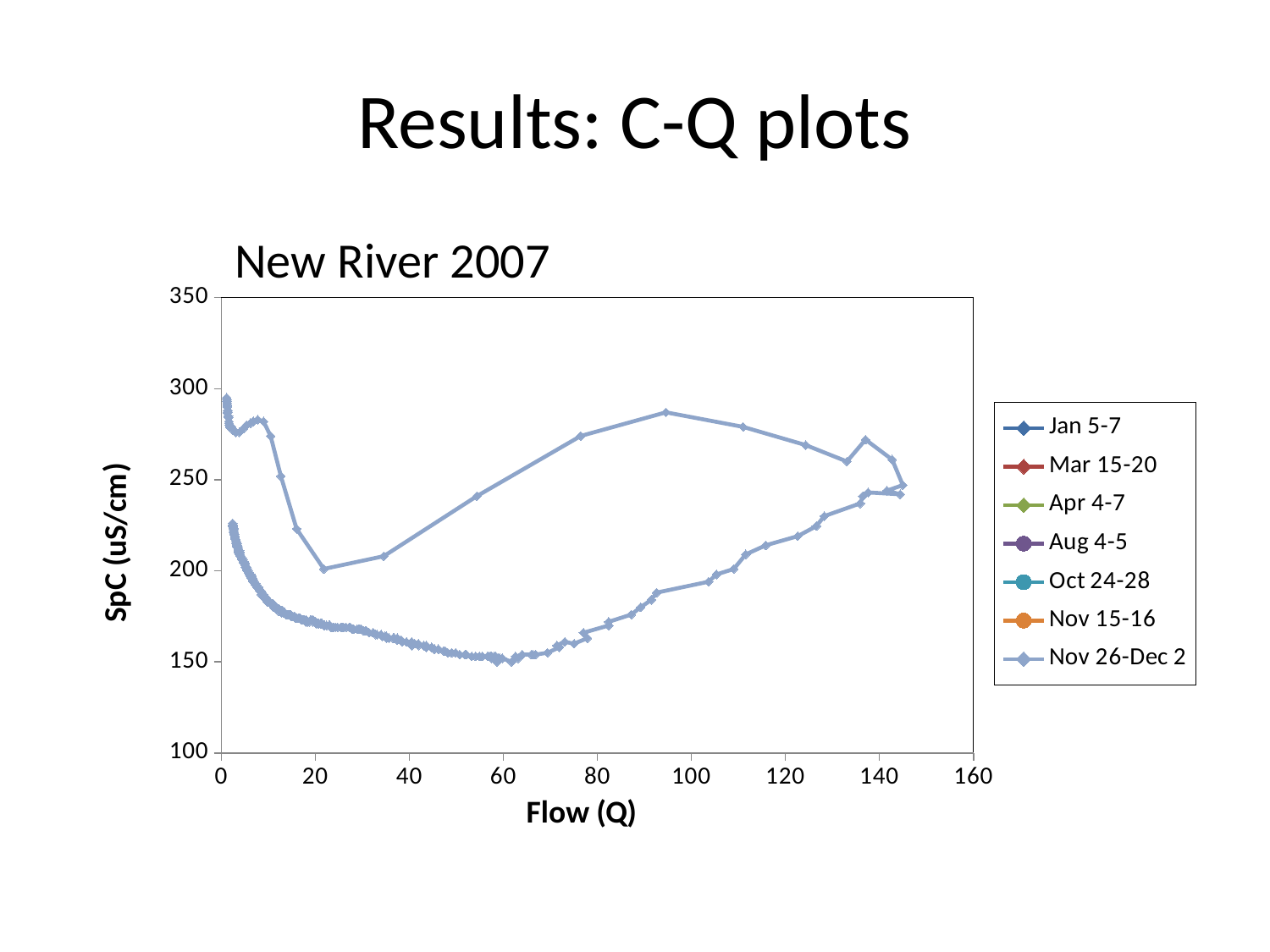
Along the lower curve, do SpC values rise or fall as Flow increases from 0 to 40? fall Is the lowest SpC value on the lower curve (near Flow 60) greater or less than 200? less What is the label of the x axis? Flow (Q) What is the title of the chart? New River 2007 What is the label of the y axis? SpC (uS/cm) Along the upper curve, do SpC values rise or fall as Flow increases from 20 to 80? rise Is the SpC value on the upper curve at Flow 60 greater or less than 200? greater How many series does the legend list? 7 Is the SpC value on the lower curve at Flow 40 greater or less than 200? less What kind of chart is shown on the slide? Line chart (scatter with lines)